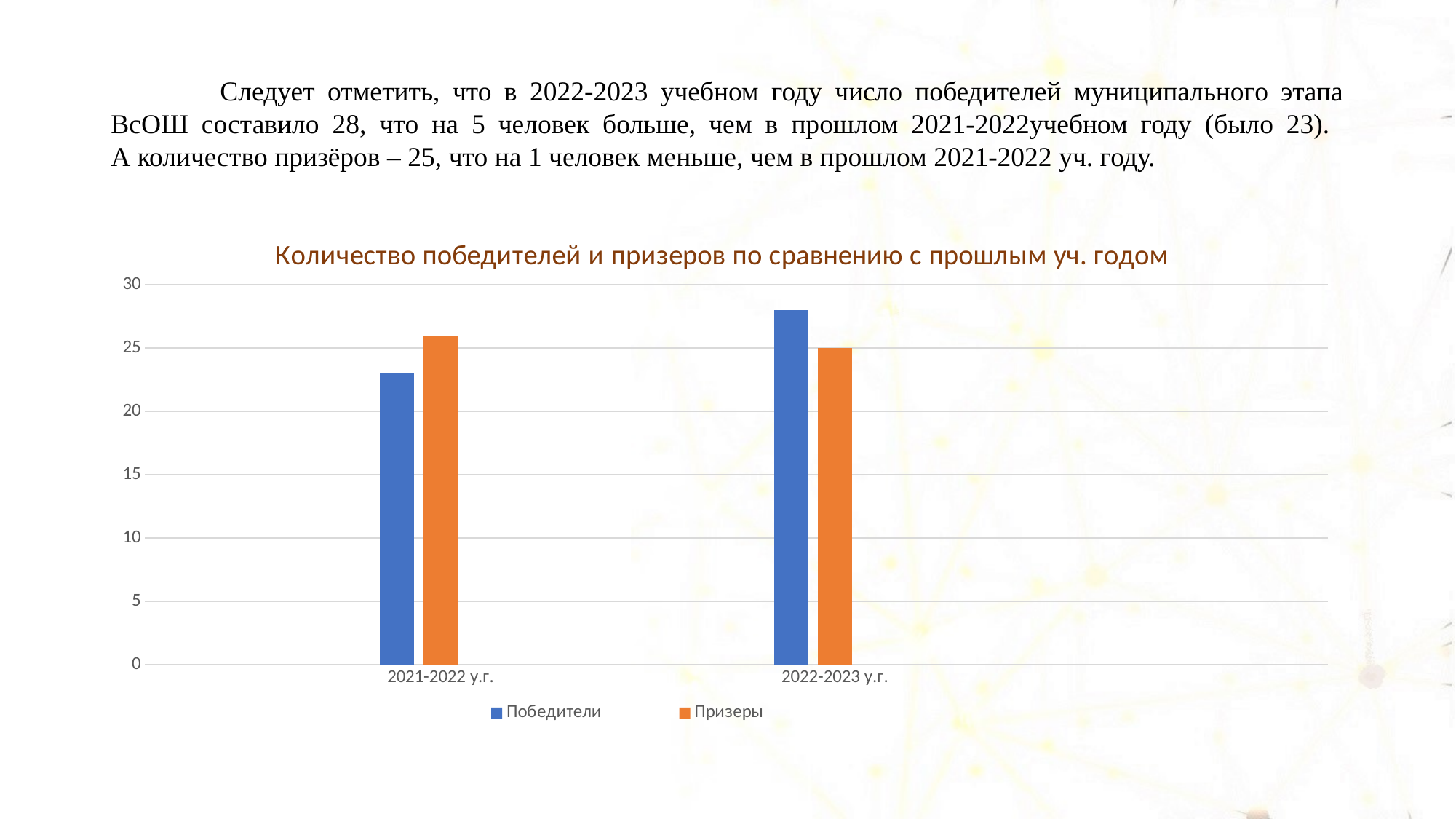
Is the value for Призеры in 2021-2022 у.г. greater or less than 20? greater How many series does the chart legend list? 2 By how much did the number of Победители increase from 2021-2022 у.г. to 2022-2023 у.г.? 5 Which bar is the highest in the chart? Победители, 2022-2023 у.г. What is the title of the chart? Количество победителей и призеров по сравнению с прошлым уч. годом In 2021-2022 у.г., which is larger: Победители or Призеры? Призеры What is the value for Победители in 2021-2022 у.г.? 23 What type of chart is shown on the slide? bar chart How many categories (academic years) are shown on the x axis? 2 What is the value for Победители in 2022-2023 у.г.? 28 What is the value for Призеры in 2022-2023 у.г.? 25 Which bar is the lowest in the chart? Победители, 2021-2022 у.г.